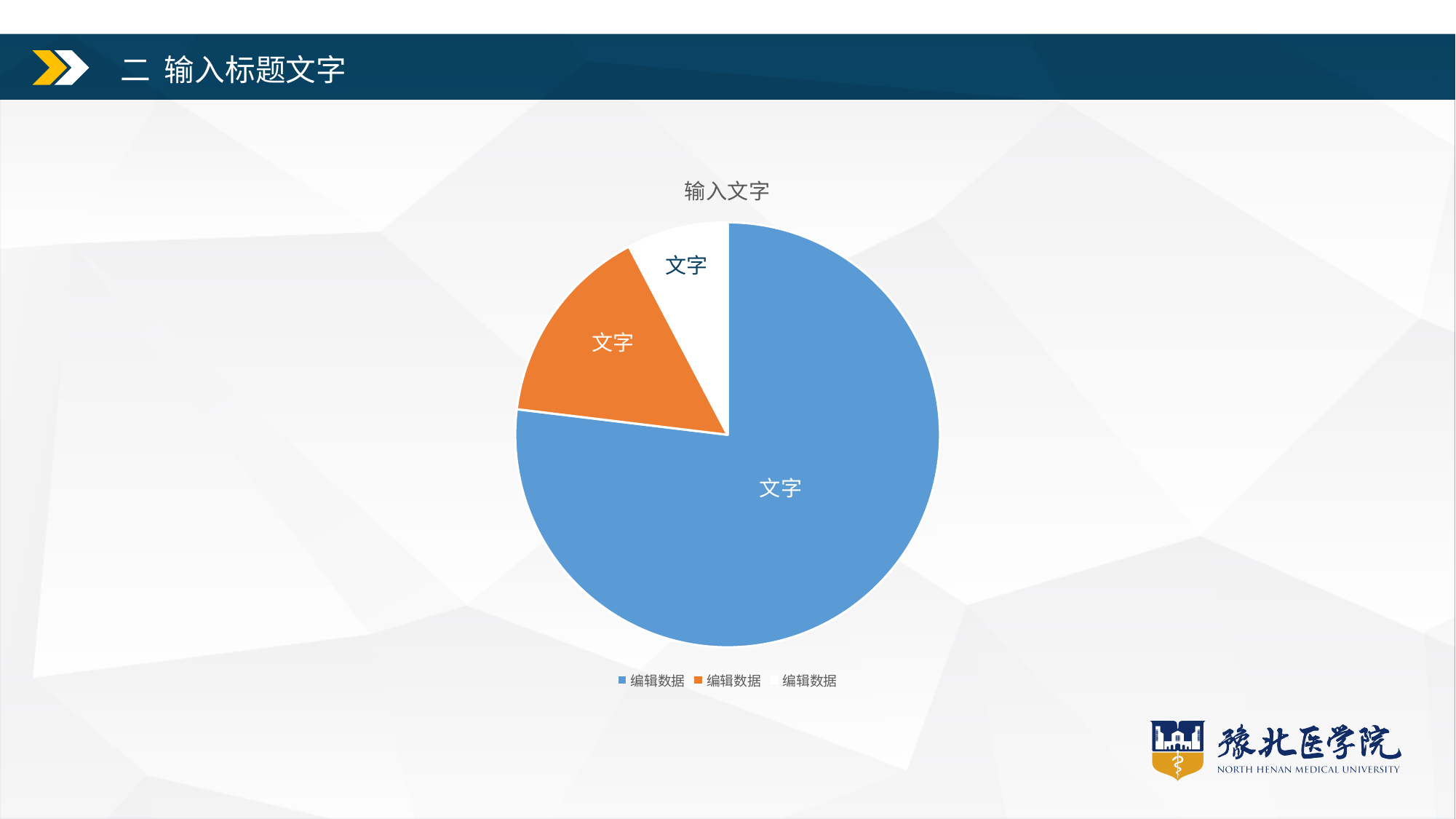
Which slice of the pie chart is the smallest? the white slice Does the blue slice take up more or less than half of the pie? more Which is larger, the blue slice or the orange slice? the blue slice Which is larger, the orange slice or the white slice? the orange slice Which slice of the pie chart is the largest? the blue slice What is the title of the chart? 输入文字 What kind of chart is shown on the slide? pie chart How many entries does the chart's legend list? 3 What text is used for the legend entries of the chart? 编辑数据 How many slices does the pie chart have? 3